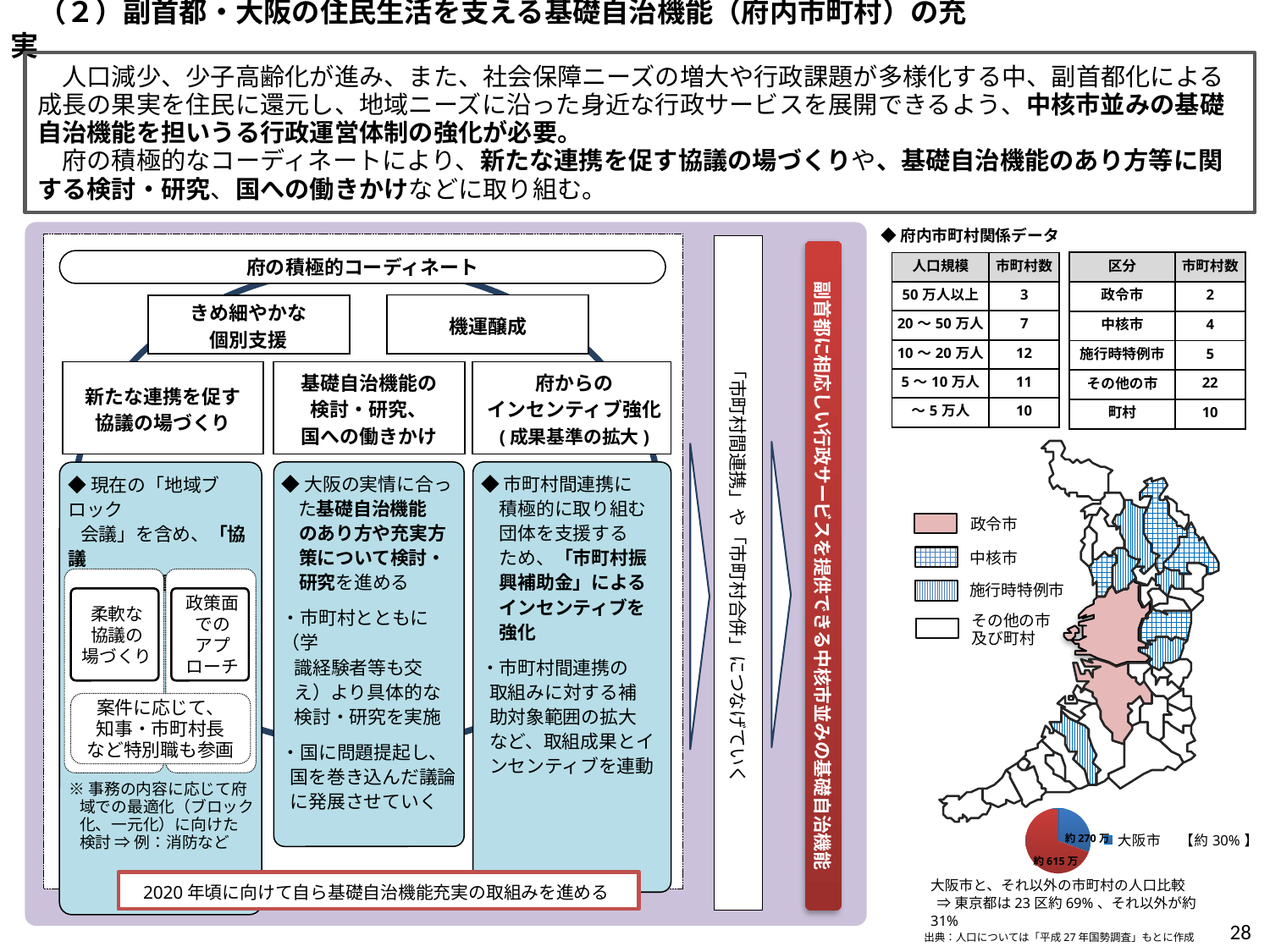
What is the caption/title written under the pie chart at the bottom right? 大阪市と、それ以外の市町村の人口比較 In the pie chart at the bottom right, which is larger: the 大阪市 slice or the slice for the other municipalities? the other municipalities (それ以外の市町村) How many slices does the pie chart at the bottom right have? 2 In the pie chart at the bottom right, what value label is shown for 大阪市? 約270万 According to the label next to the pie chart, what share of the population does 大阪市 account for? 約30% What colour is the 大阪市 slice in the pie chart at the bottom right? blue In the pie chart at the bottom right, which slice is the smallest? 大阪市 What kind of chart is shown at the bottom right of the slide, below the map? pie chart In the pie chart at the bottom right, what value label is shown for the slice other than 大阪市 (それ以外の市町村)? 約615万